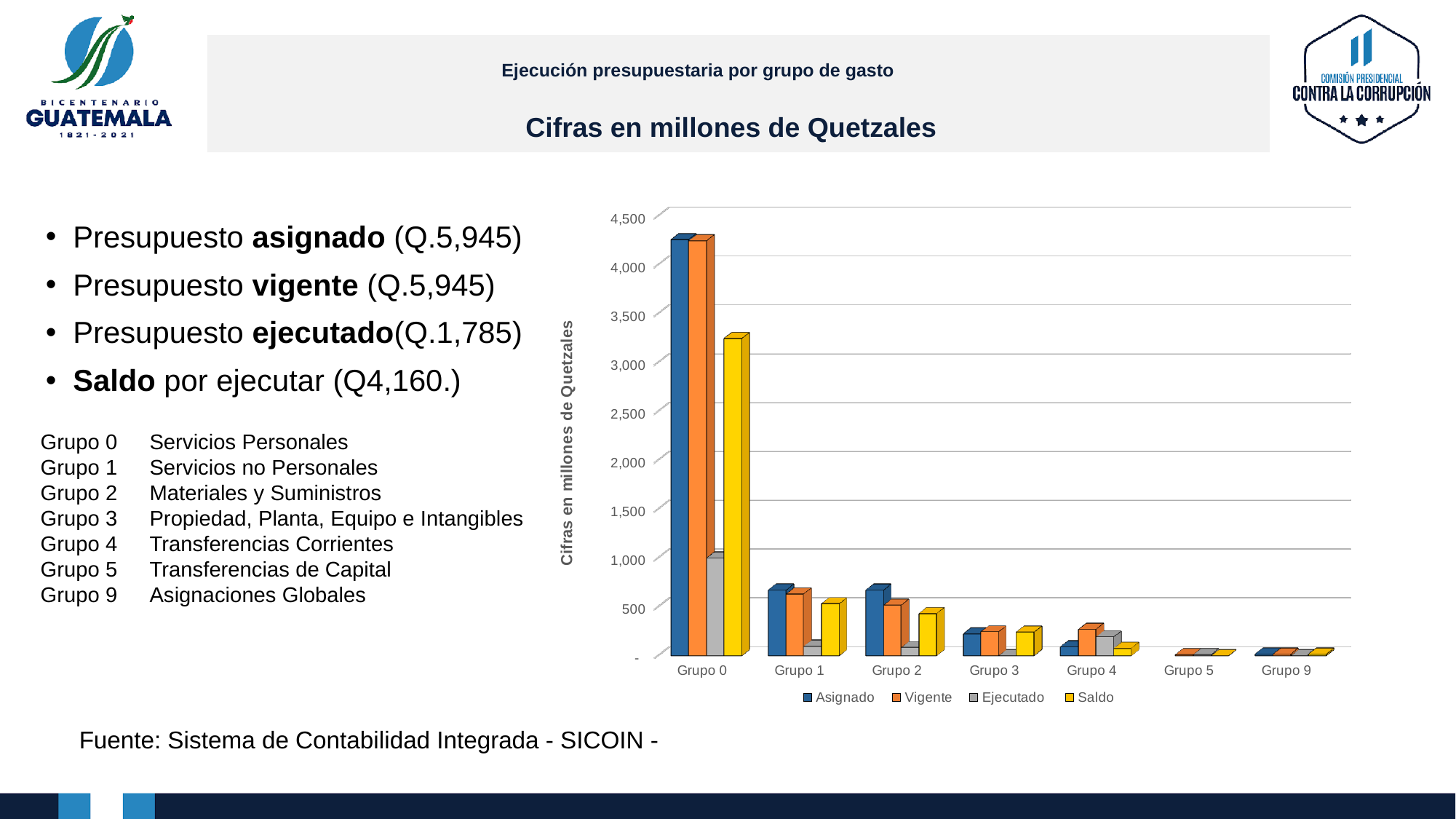
How many groups (categories) are shown on the x axis of the chart? 7 For Grupo 0, which is larger: the Asignado value or the Ejecutado value? Asignado Is the Asignado value for Grupo 3 greater or less than 500? less What is the title of the vertical axis of the chart? Cifras en millones de Quetzales Is the Saldo value for Grupo 0 greater or less than 3,000? greater How many series does the chart legend list? 4 Is the Ejecutado value for Grupo 0 greater or less than 1,500? less Which group has the highest Asignado value in the chart? Grupo 0 Do the Asignado values generally rise or fall from Grupo 0 to Grupo 9? fall What kind of chart is shown on the slide? Bar chart